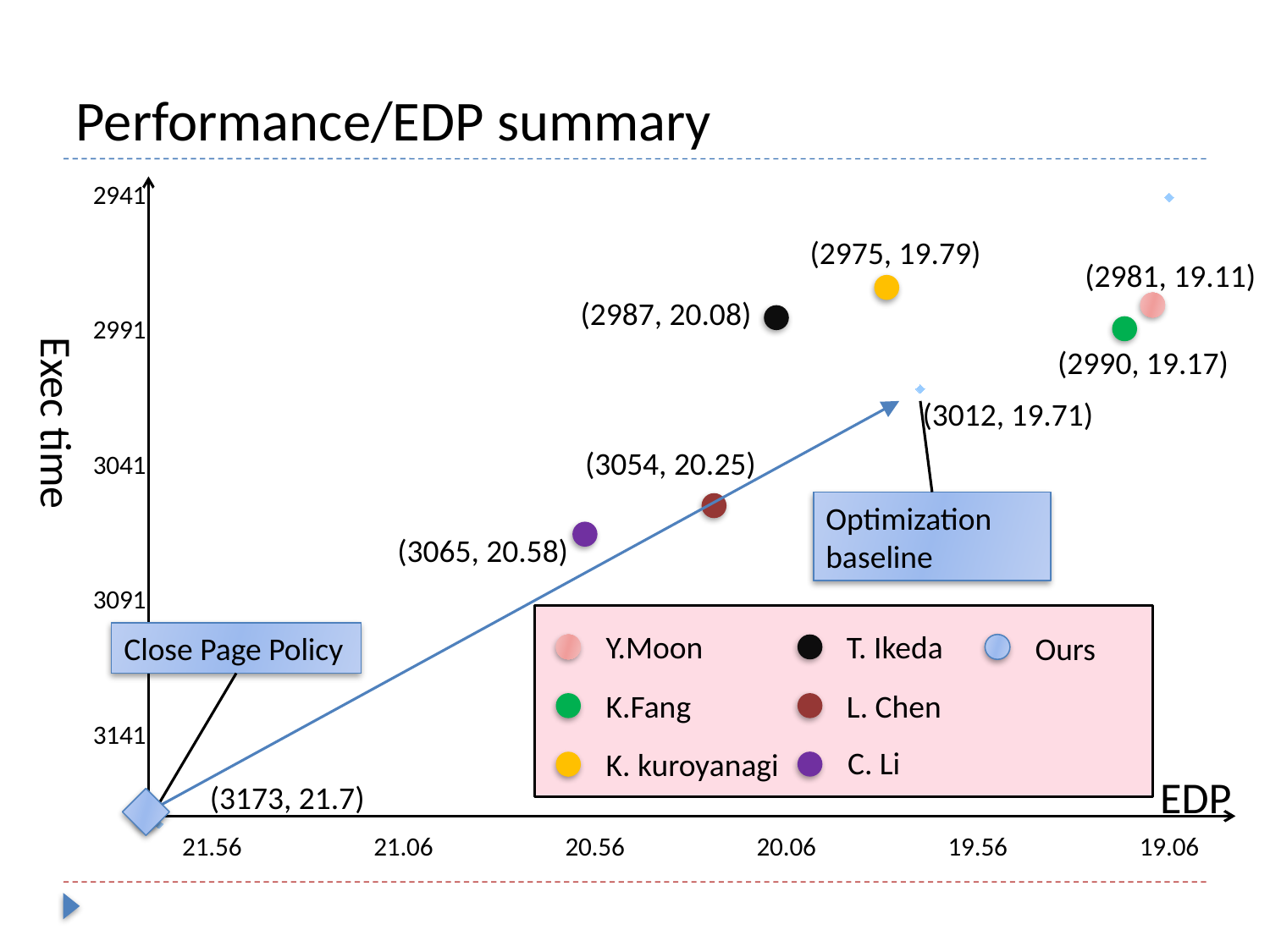
What are the (exec time, EDP) coordinates labelled for the K. kuroyanagi point? (2975, 19.79) What is the difference in EDP between the Close Page Policy point (21.7) and the Optimization baseline point (19.71)? 1.99 Which labelled point has the largest exec time value? Close Page Policy (3173) What are the coordinates labelled for the T. Ikeda point? (2987, 20.08) Which labelled point has the smallest exec time value? K. kuroyanagi (2975) How many entries does the legend list? 7 What is the label of the vertical axis? Exec time Which has the larger EDP value, the Y.Moon point or the K.Fang point? K.Fang (19.17) What is the difference in exec time between the C. Li point (3065) and the L. Chen point (3054)? 11 What kind of chart is shown on the slide? scatter chart What are the coordinates labelled for the Optimization baseline point? (3012, 19.71) What are the coordinates labelled for the Close Page Policy point? (3173, 21.7)